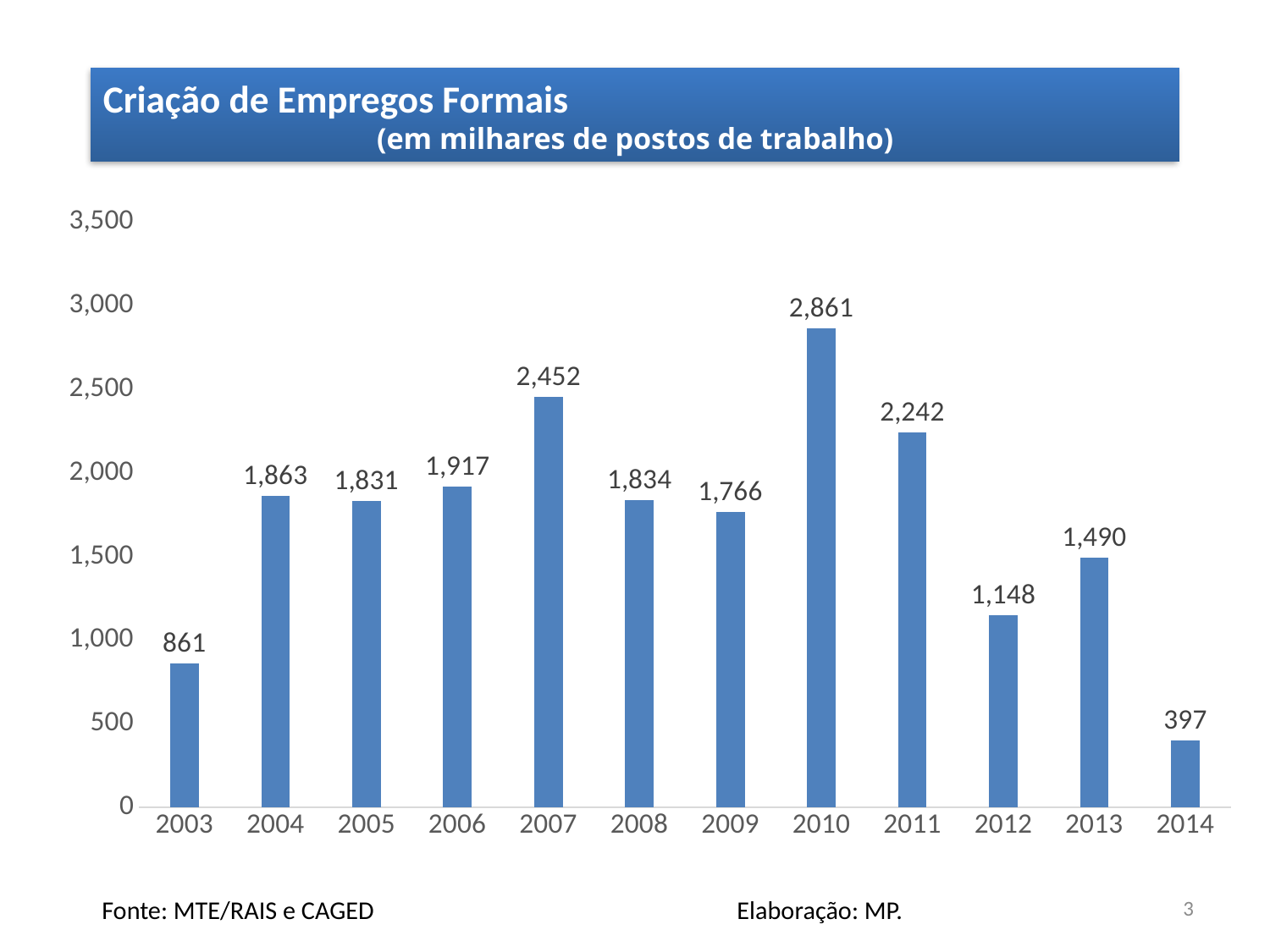
What is the difference between the values for 2010 and 2011? 619 Is the value for 2003 greater or less than 1,000? less What kind of chart is shown on the slide? bar chart Which year has the highest value? 2010 Do the values rise or fall from 2011 to 2012? fall What is the value for 2007? 2,452 What is the value for 2014? 397 What is the difference between the values for 2013 and 2012? 342 Which is larger, the value for 2004 or the value for 2005? 2004 What is the value for 2010? 2,861 Which year has the lowest value? 2014 How many years are shown on the x axis? 12